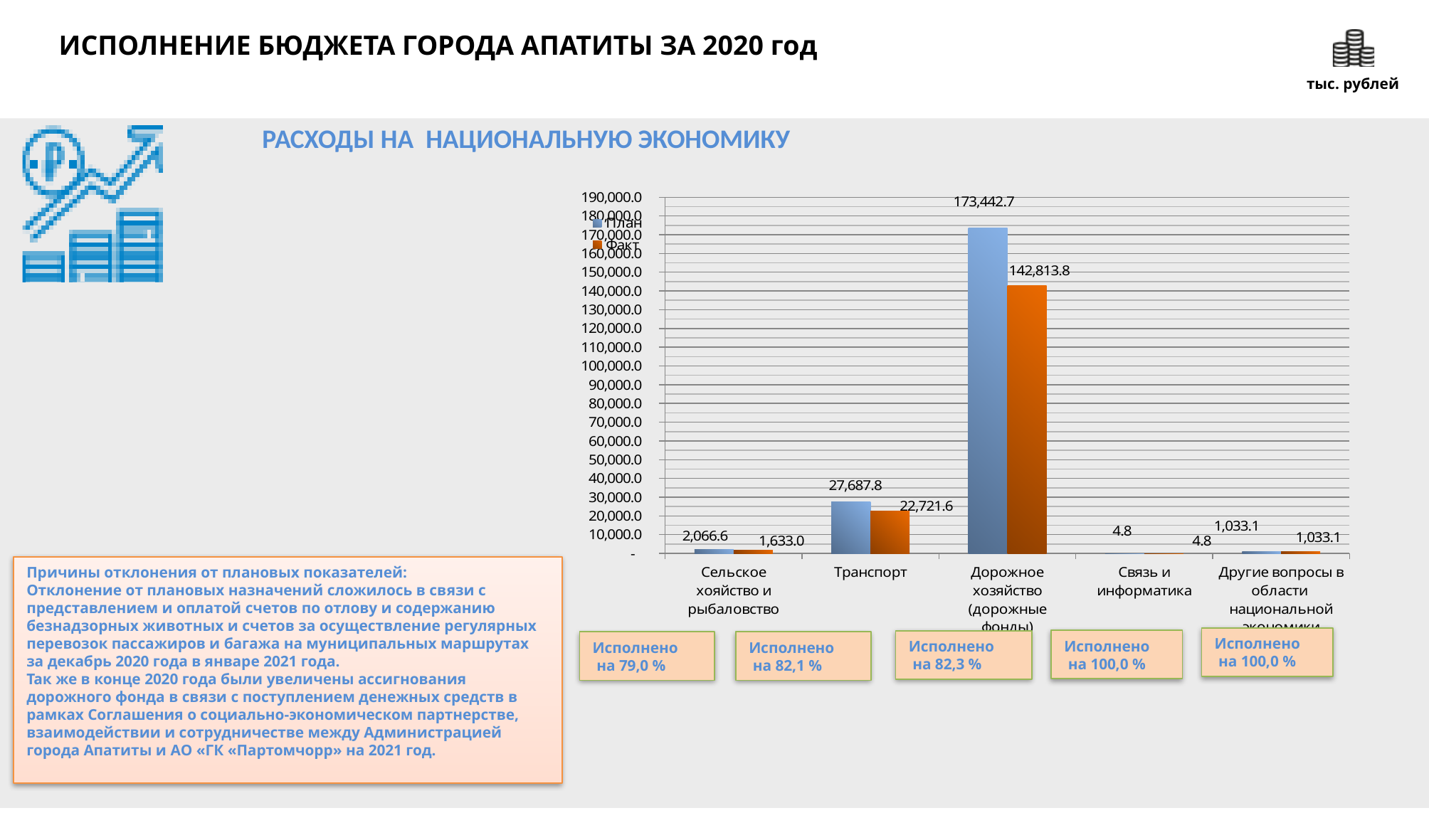
How many categories are shown on the x axis of the chart? 5 What is the difference between the План and Факт values for Дорожное хозяйство (дорожные фонды)? 30,628.9 What is the План value for Транспорт? 27,687.8 What is the План value for Связь и информатика? 4.8 How many series does the chart legend list? 2 What is the Факт value for Дорожное хозяйство (дорожные фонды)? 142,813.8 What kind of chart is shown on the slide? Bar chart What is the Факт value for Сельское хозяйство и рыбаловство? 1,633.0 What is the difference between the План and Факт values for Транспорт? 4,966.2 Which category has the highest План value? Дорожное хозяйство (дорожные фонды) Which is larger for Сельское хозяйство и рыбаловство, the План value or the Факт value? План Which category has the lowest Факт value? Связь и информатика